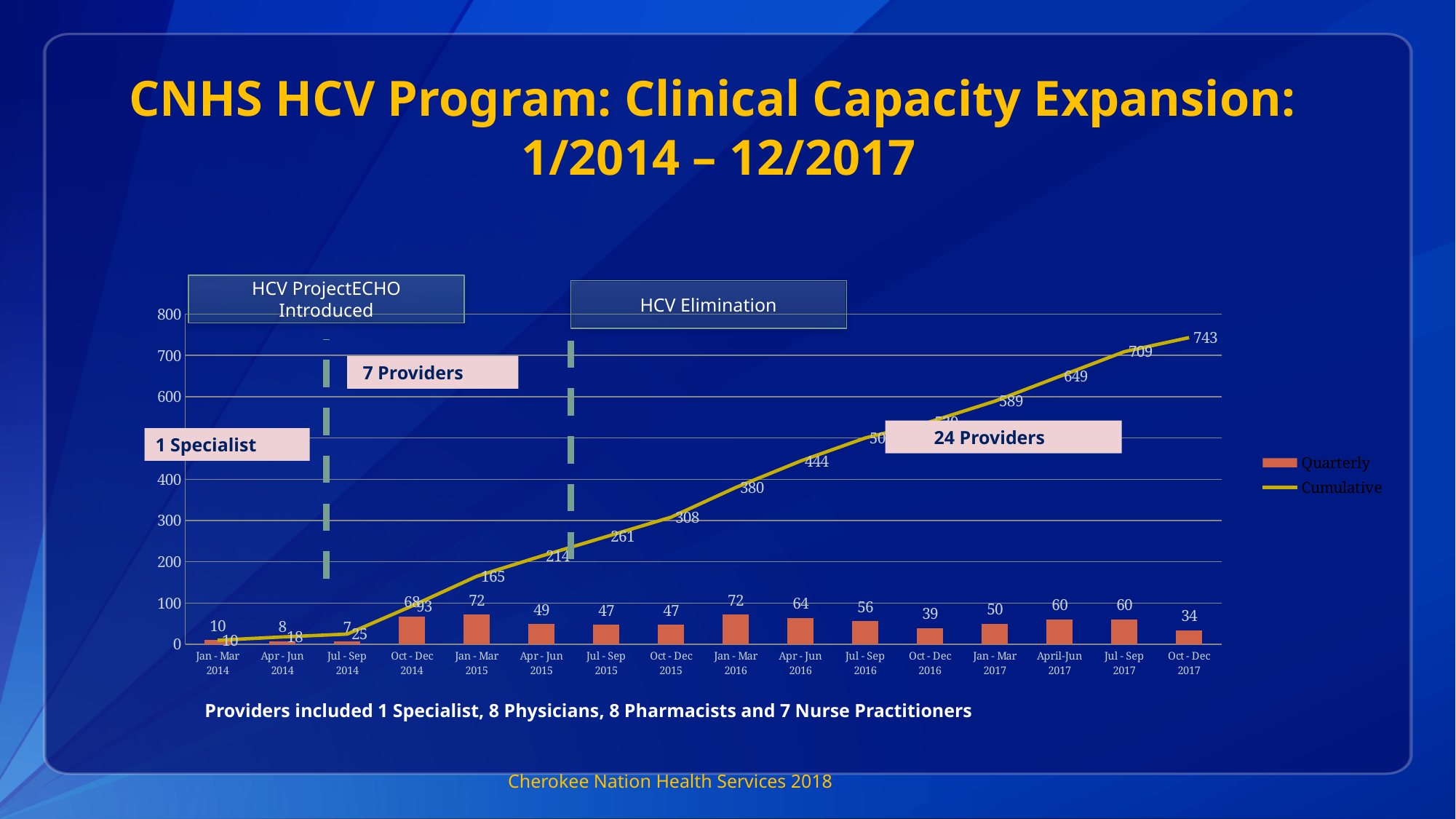
Which has the larger Quarterly value, Apr - Jun 2016 or Jul - Sep 2016? Apr - Jun 2016 How many quarters are shown on the x axis? 16 Which quarter has the lowest Quarterly value? Jul - Sep 2014 How many series does the legend list? 2 What is the Quarterly value for Jan - Mar 2016? 72 Does the Cumulative line rise or fall from Jan - Mar 2014 to Oct - Dec 2017? Rises What kind of chart is shown on the slide? Combination bar and line chart What is the Cumulative value for Jan - Mar 2015? 165 What is the Cumulative value for Oct - Dec 2017? 743 Is the Cumulative value for Jan - Mar 2016 greater or less than 400? less By how much did the Cumulative value increase from Jul - Sep 2017 to Oct - Dec 2017? 34 What is the difference between the Quarterly values for Jul - Sep 2017 and Oct - Dec 2017? 26